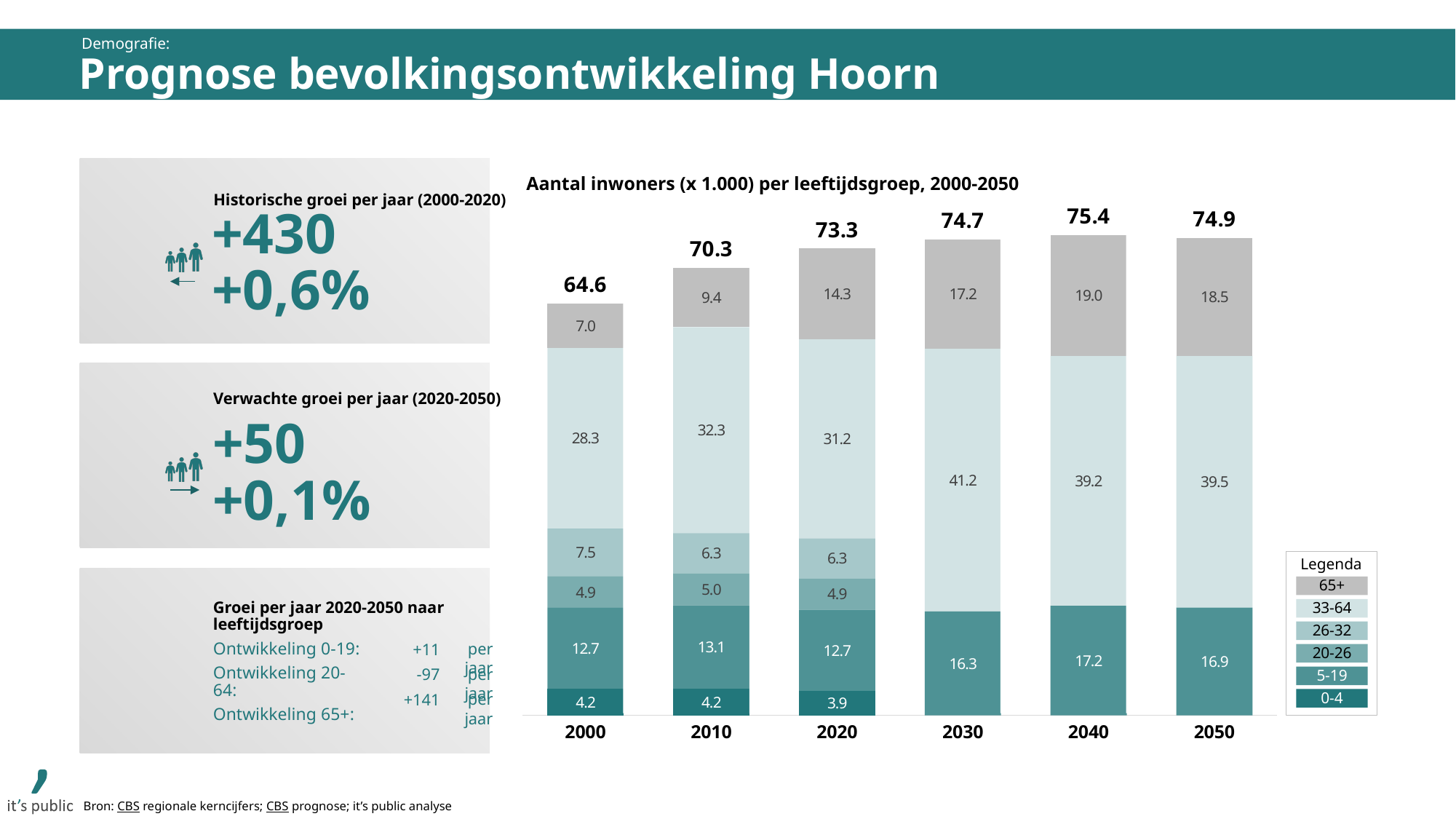
What is the value for the 65+ age group in 2020? 14.3 What is the total of the stacked bar for 2020? 73.3 What is the value for the 33-64 age group in 2010? 32.3 How many age groups does the legend list? 6 How many years are shown on the x axis of the chart? 6 What is the value for the 0-4 age group in 2020? 3.9 What is the difference between the total for 2050 and the total for 2000? 10.3 Which year has the highest total number of inhabitants? 2040 Which is larger: the 65+ value in 2000 or in 2010? 2010 What is the title of the chart? Aantal inwoners (x 1.000) per leeftijdsgroep, 2000-2050 What kind of chart is shown on the slide? Stacked bar chart Which year has the lowest total number of inhabitants? 2000